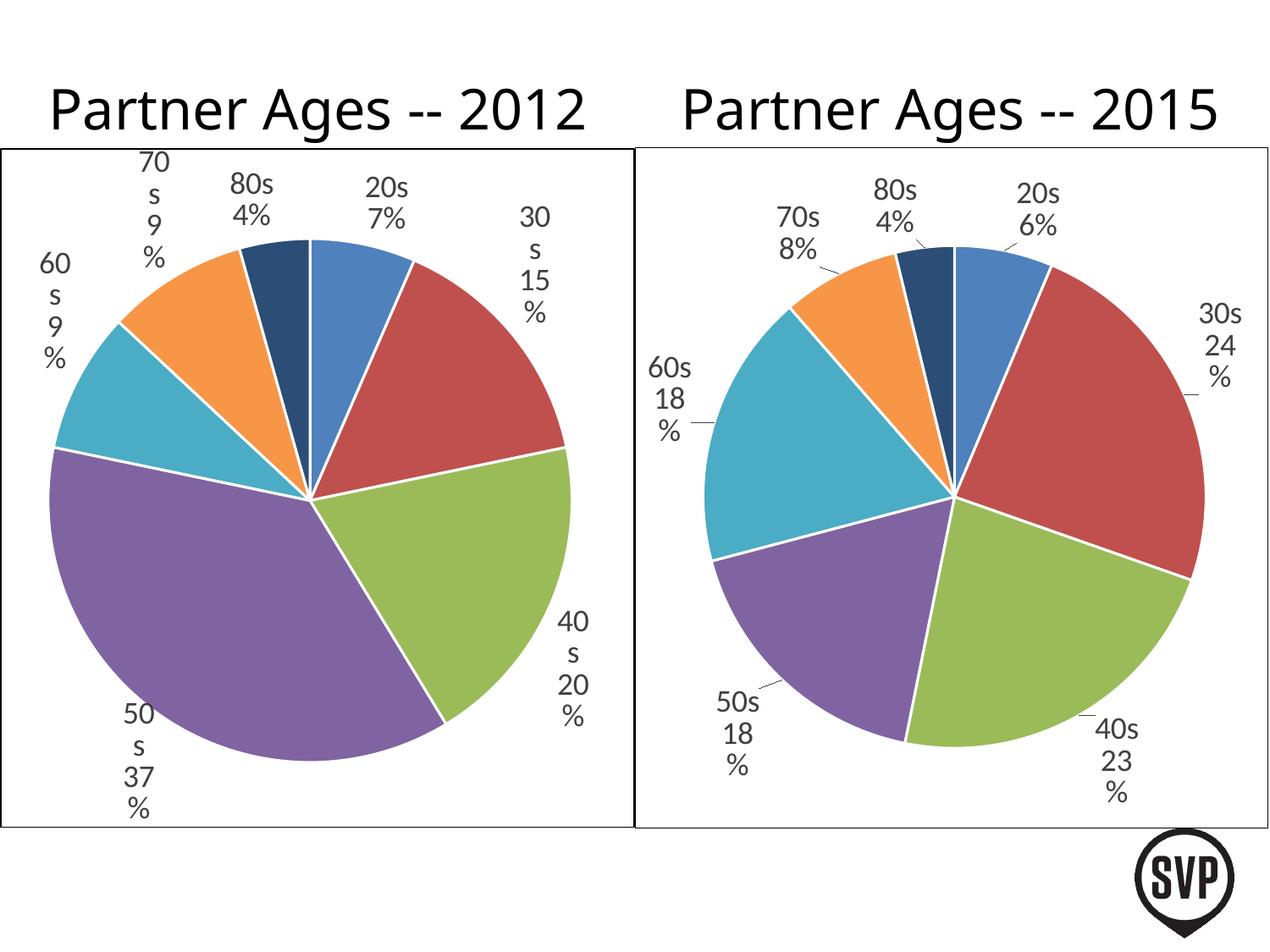
In the Partner Ages -- 2012 chart, what share of partners are in their 60s? 9% In the Partner Ages -- 2012 chart, which is larger, the 40s slice or the 30s slice? 40s In the Partner Ages -- 2015 chart, what is the difference in percentage points between the 30s and 50s slices? 6 In the Partner Ages -- 2012 chart, which age group has the largest share? 50s What is the difference in percentage points between the 50s share in the 2012 chart and the 50s share in the 2015 chart? 19 In the Partner Ages -- 2015 chart, what share of partners are in their 60s? 18% In the Partner Ages -- 2012 chart, what share of partners are in their 50s? 37% In the Partner Ages -- 2015 chart, which age group has the smallest share? 80s What is the title of the chart on the right side of the slide? Partner Ages -- 2015 How many age groups are shown in the Partner Ages -- 2015 chart? 7 In the Partner Ages -- 2015 chart, what share of partners are in their 30s? 24% What kind of chart is Partner Ages -- 2012? Pie chart